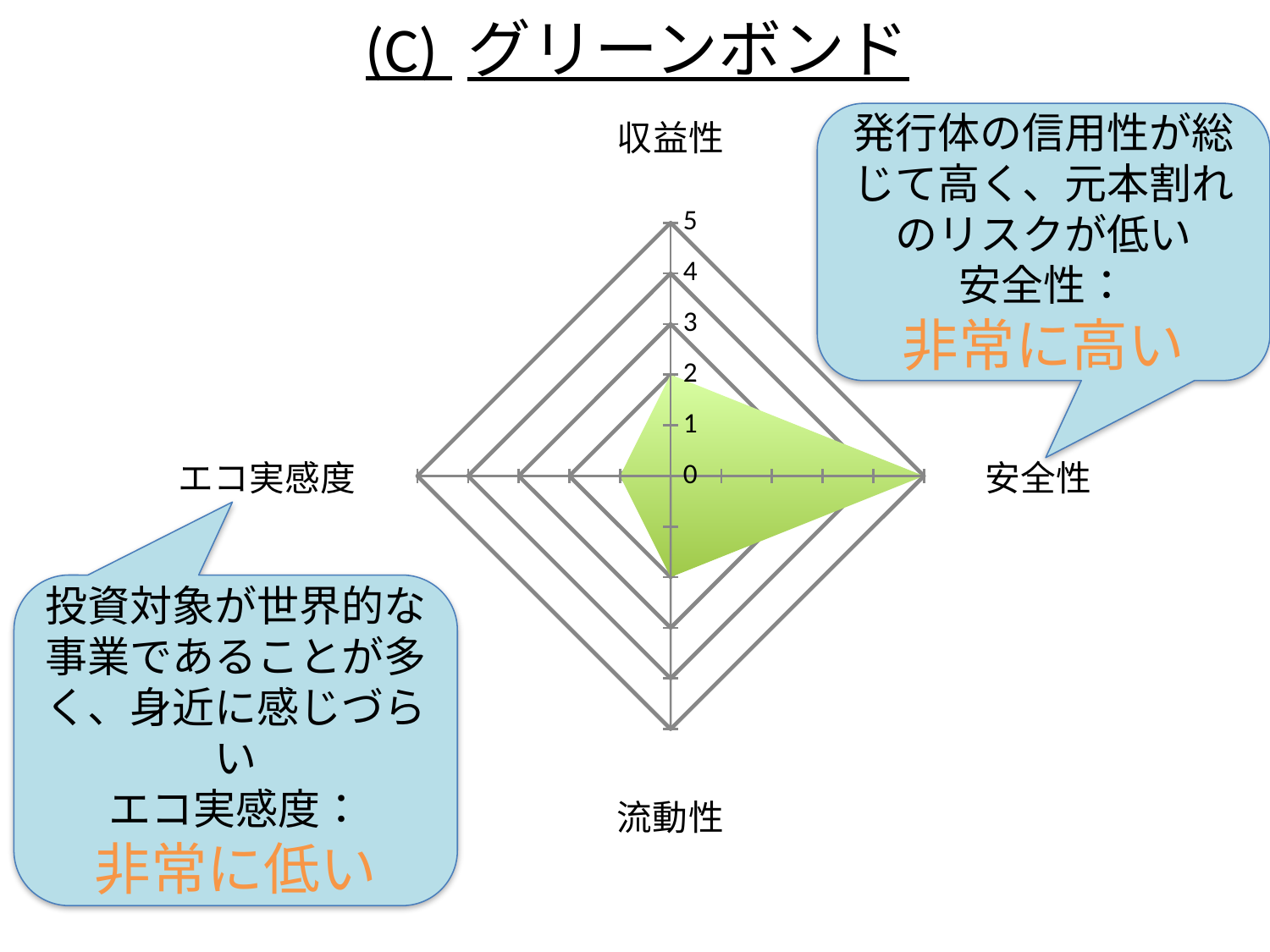
Which category has the highest value in the radar chart? 安全性 What kind of chart is shown on the slide? Radar chart What is the value for 安全性 in the radar chart? 5 What is the title of the slide containing the radar chart? (C) グリーンボンド What is the value for エコ実感度 in the radar chart? 1 What is the difference between the value for 安全性 and the value for エコ実感度? 4 How many axes (categories) does the radar chart have? 4 Is the value for 安全性 greater or less than 3? greater What is the value for 収益性 in the radar chart? 2 Which is larger in the radar chart, the value for 安全性 or the value for 流動性? 安全性 What is the maximum value shown on the radar chart's axis scale? 5 Which category has the lowest value in the radar chart? エコ実感度